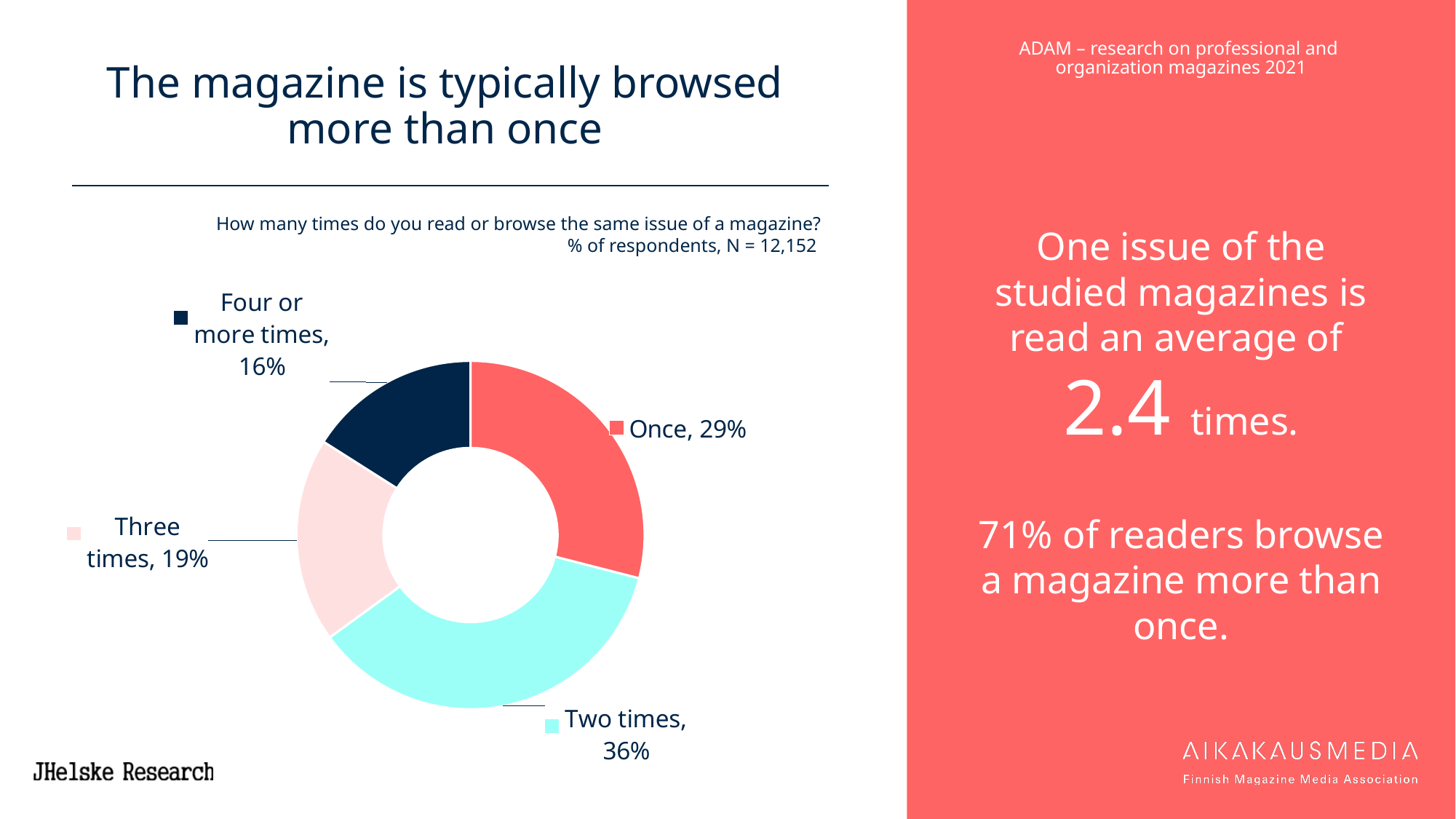
What kind of chart is shown on the slide? Doughnut (pie) chart Which category has the smallest share of respondents? Four or more times Which is larger, the share for 'Three times' or the share for 'Four or more times'? Three times What percentage of respondents read or browse the same issue four or more times? 16% What is the difference in percentage points between 'Two times' and 'Once'? 7 What colour is the 'Two times' segment of the chart? Light blue (cyan) Which category has the largest share of respondents? Two times What percentage of respondents read or browse the same issue two times? 36% How many categories does the chart show? 4 What is the number of respondents (N) stated for the chart? 12,152 What percentage of respondents read or browse the same issue three times? 19% What percentage of respondents read or browse the same issue of a magazine once? 29%